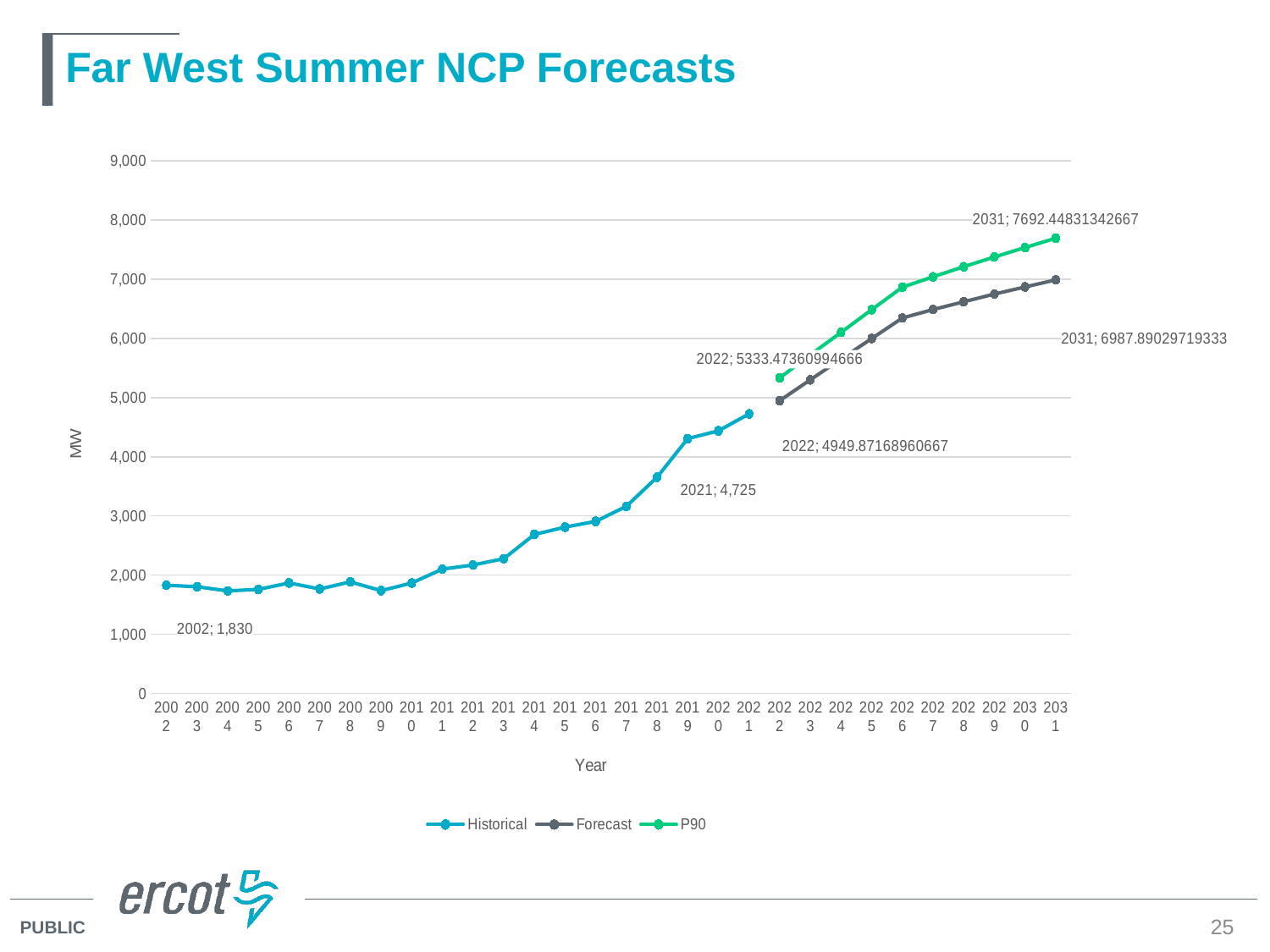
In 2031, which series has the larger value, P90 or Forecast? P90 By how much did the Historical value increase from 2002 to 2021? 2,895 What kind of chart is shown on the slide? Line chart How many series does the legend list? 3 Is the Forecast value for 2026 greater or less than 6,000? greater What is the P90 value for 2022? 5333.47360994666 What is the Historical value for 2021? 4,725 What is the P90 value for 2031? 7692.44831342667 What is the label on the vertical axis? MW What is the Forecast value for 2031? 6987.89029719333 What is the Historical value for 2002? 1,830 What is the Forecast value for 2022? 4949.87168960667